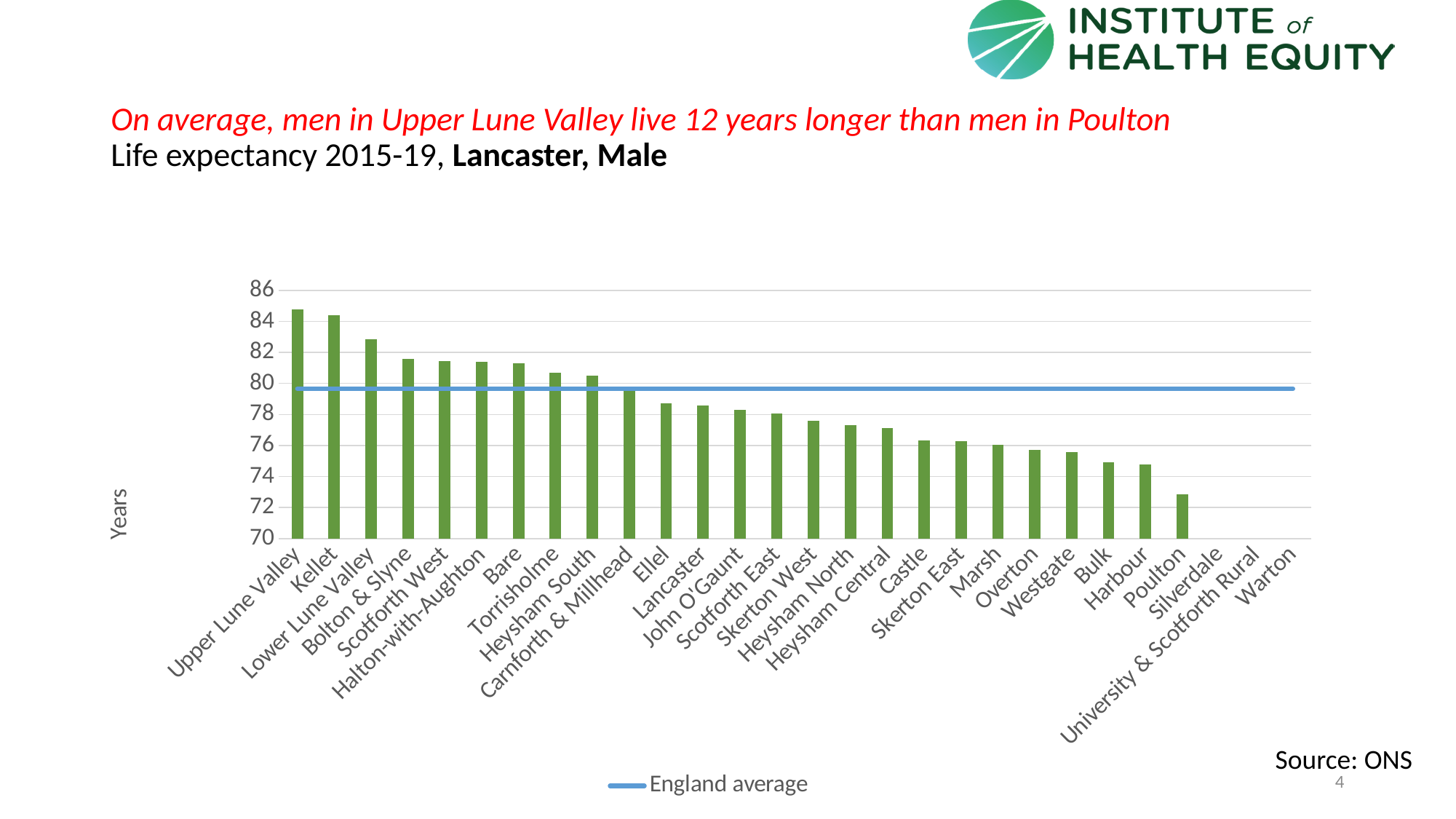
Is the value for Poulton greater or less than 74? less What kind of chart is shown on the slide? Bar chart Do the bar values rise or fall moving from left to right along the x axis? Fall Which is larger, the value for Castle or the value for Harbour? Castle Is the value for Ellel greater or less than 80? less Which is larger, the value for Bare or the value for Ellel? Bare Which ward has the highest male life expectancy in the chart? Upper Lune Valley Is the value for Lower Lune Valley greater or less than 82? greater How many entries does the legend list? 1 What is the label on the vertical axis of the chart? Years Which ward with a bar shown has the lowest male life expectancy in the chart? Poulton